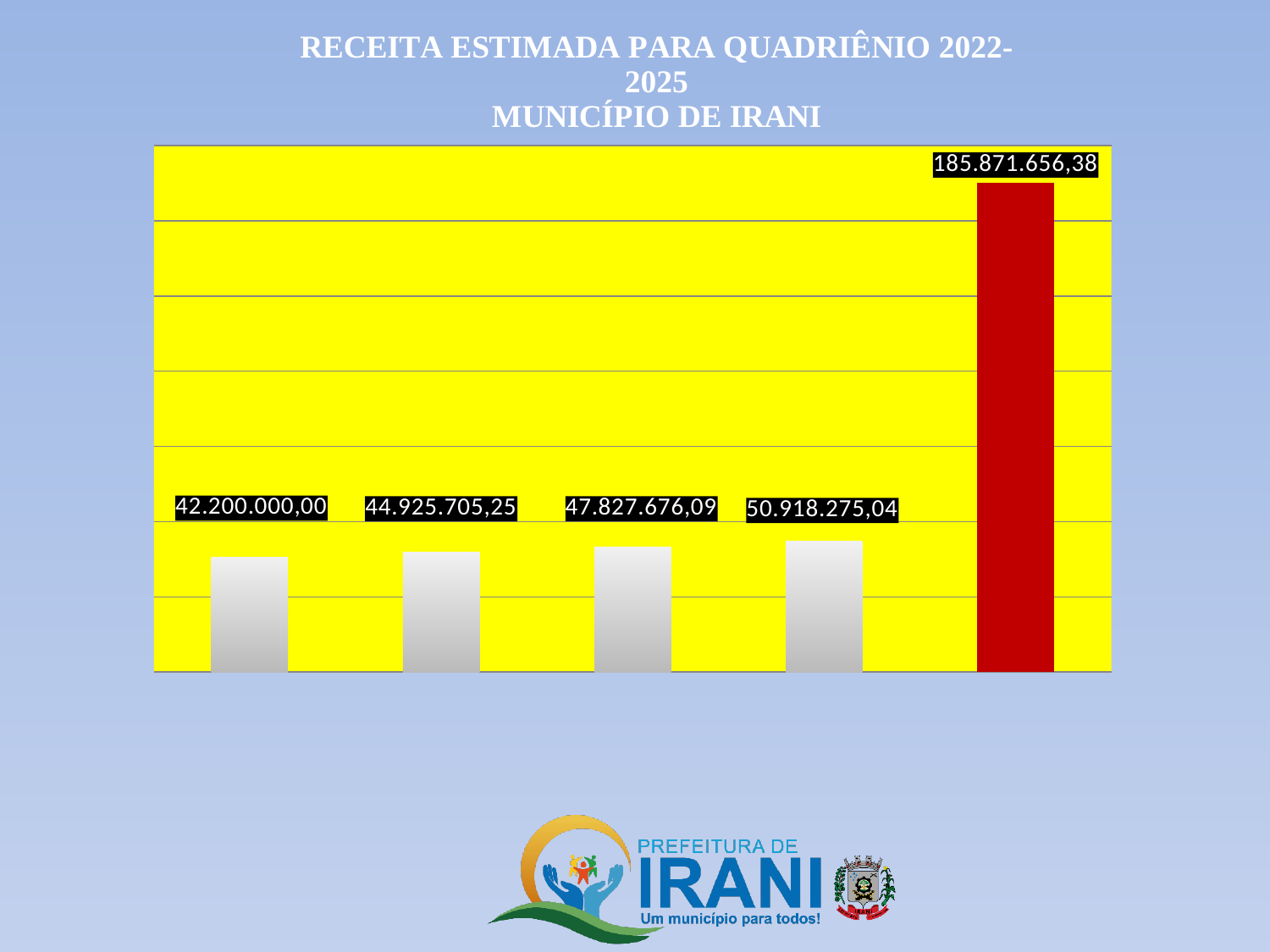
What is the difference between the second bar (44.925.705,25) and the first bar (42.200.000,00)? 2.725.705,25 What value is labelled on the second bar from the left? 44.925.705,25 What value is labelled on the fourth bar from the left? 50.918.275,04 How many bars are plotted in the chart? 5 What colour is the tallest bar in the chart? Red What value is labelled on the third bar from the left? 47.827.676,09 What is the value shown on the tallest (red) bar? 185.871.656,38 What is the difference between the rightmost bar (185.871.656,38) and the fourth bar (50.918.275,04)? 134.953.381,34 Do the bar values rise or fall from left to right across the chart? Rise Which is larger, the value of the third bar or the value of the fourth bar? The fourth bar (50.918.275,04) What is the value of the lowest bar in the chart? 42.200.000,00 What kind of chart is shown on the slide? Bar chart